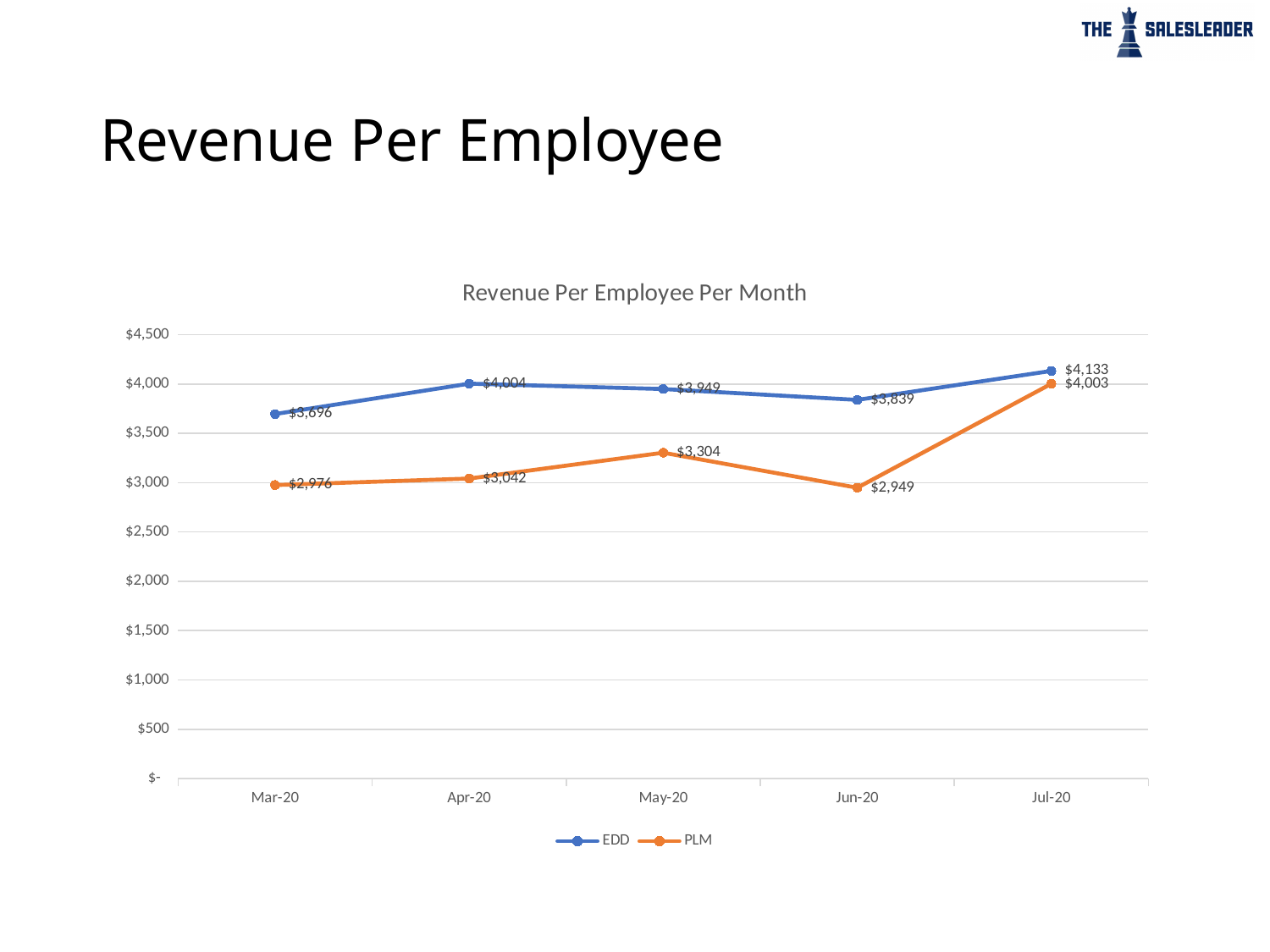
What is the PLM value for May-20? $3,304 Is the PLM value for Mar-20 greater or less than $3,000? less In which month is the EDD value highest? Jul-20 What is the title of the chart? Revenue Per Employee Per Month What is the EDD value for Mar-20? $3,696 In which month is the PLM value lowest? Jun-20 How many months are plotted on the x axis? 5 What is the PLM value for Jul-20? $4,003 How many series does the legend list? 2 Which series has the larger value in Apr-20, EDD or PLM? EDD What type of chart is shown on the slide? line chart What is the difference between the EDD and PLM values in Jun-20? $890